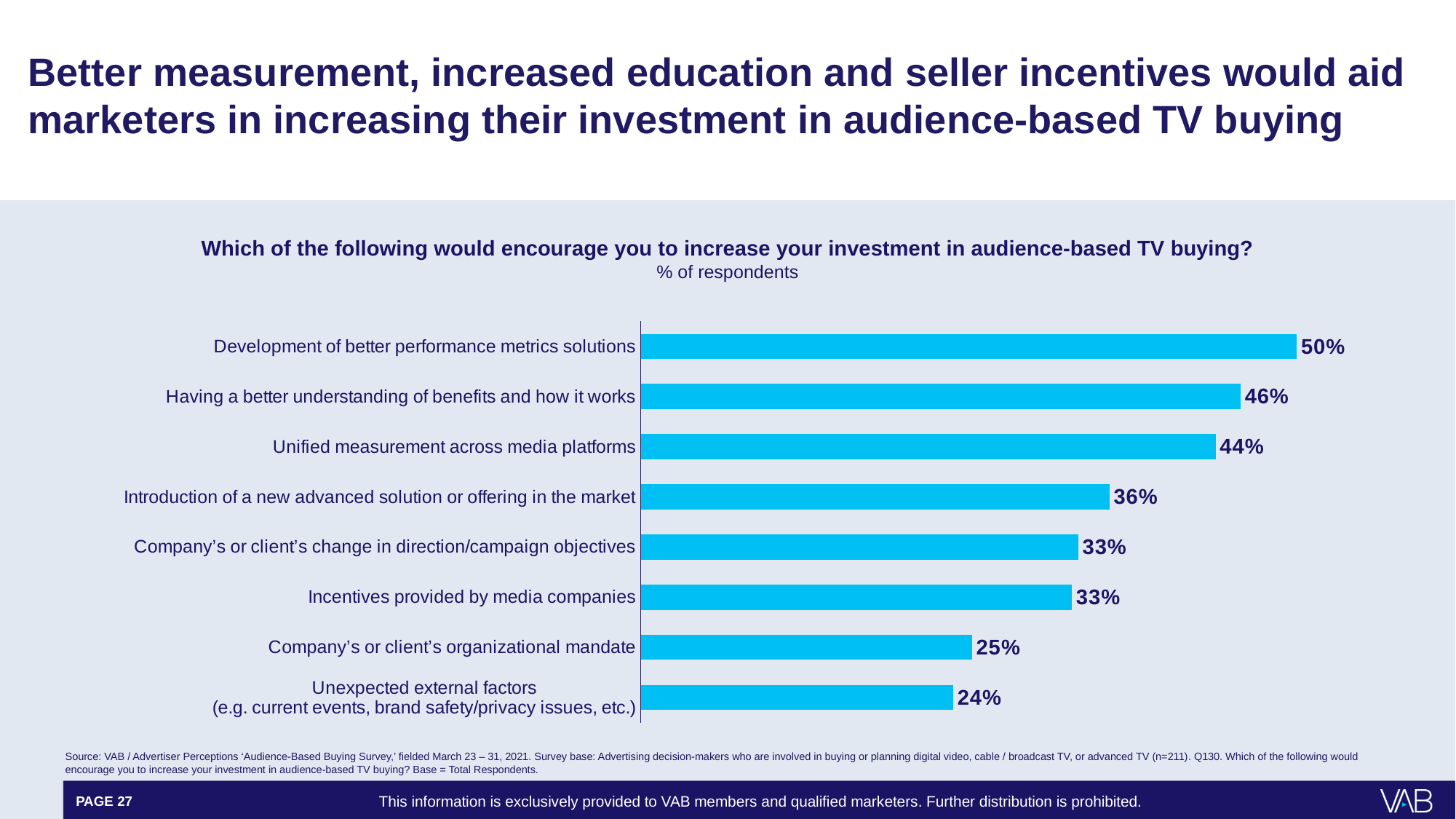
How many categories are shown in the chart? 8 Which category has the lowest percentage of respondents? Unexpected external factors (e.g. current events, brand safety/privacy issues, etc.) What is the value for 'Unified measurement across media platforms'? 44% Which is larger: 'Introduction of a new advanced solution or offering in the market' or 'Incentives provided by media companies'? Introduction of a new advanced solution or offering in the market What is the title of the chart? Which of the following would encourage you to increase your investment in audience-based TV buying? What percentage of respondents selected 'Company's or client's organizational mandate'? 25% What is the value for 'Introduction of a new advanced solution or offering in the market'? 36% What type of chart is shown on the slide? Bar chart What is the difference between 'Unified measurement across media platforms' and 'Company's or client's organizational mandate'? 19 percentage points Which category has the highest percentage of respondents? Development of better performance metrics solutions What is the difference between 'Development of better performance metrics solutions' and 'Having a better understanding of benefits and how it works'? 4 percentage points What percentage of respondents chose 'Development of better performance metrics solutions'? 50%